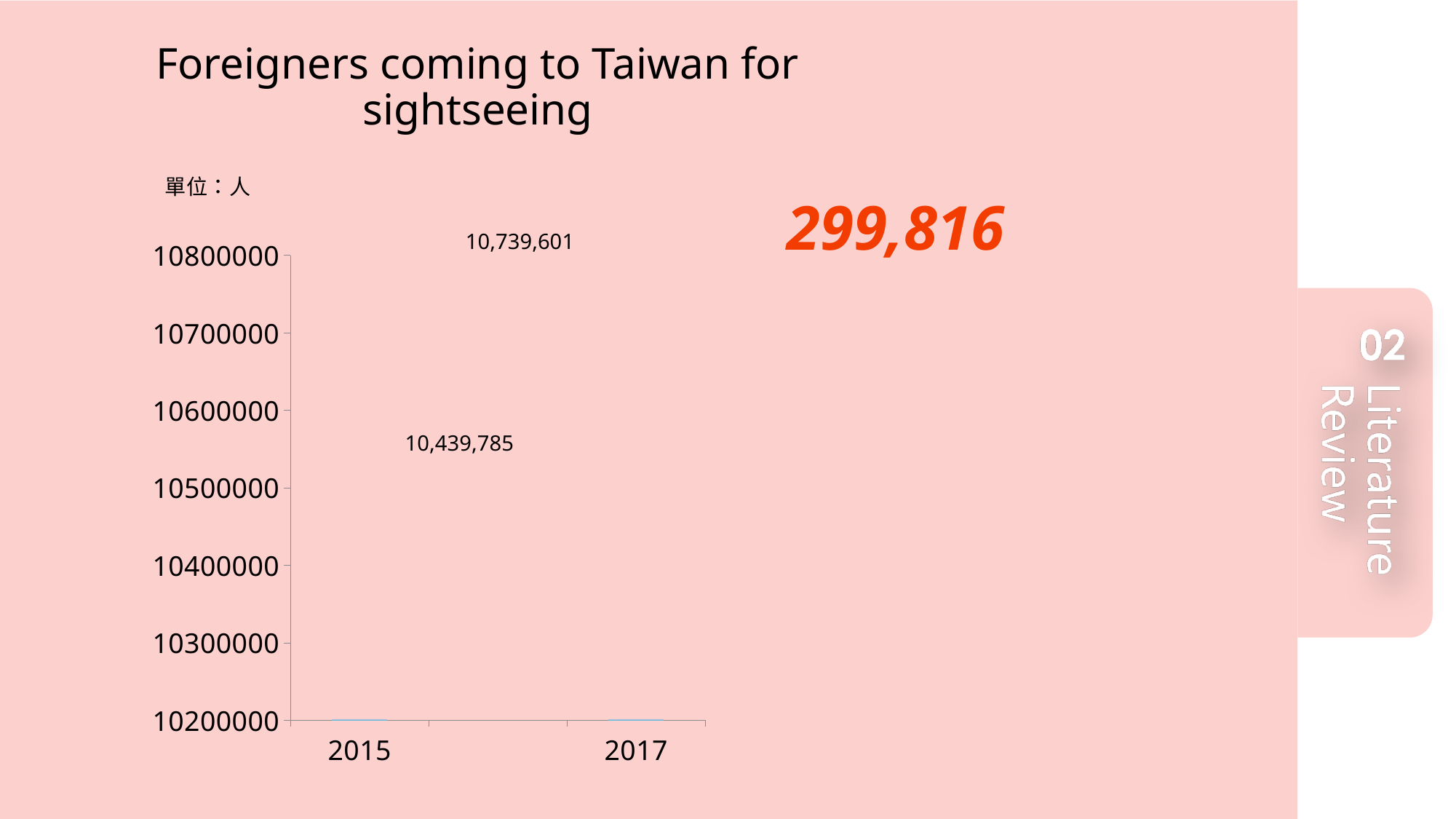
What is the lowest value shown on the y axis? 10200000 How many years are shown on the x axis? 2 Is the value for 2017 larger or smaller than the value for 2015? larger Is the value for 2015 greater or less than 10500000? less What is the value for 2015? 10,439,785 Do the values rise or fall from 2015 to 2017? rise What is the difference between the 2017 value and the 2015 value? 299,816 Is the value for 2017 greater or less than 10700000? greater What is the title of the chart? Foreigners coming to Taiwan for sightseeing What is the value for 2017? 10,739,601 Which year has the higher value? 2017 Which year has the lower value? 2015